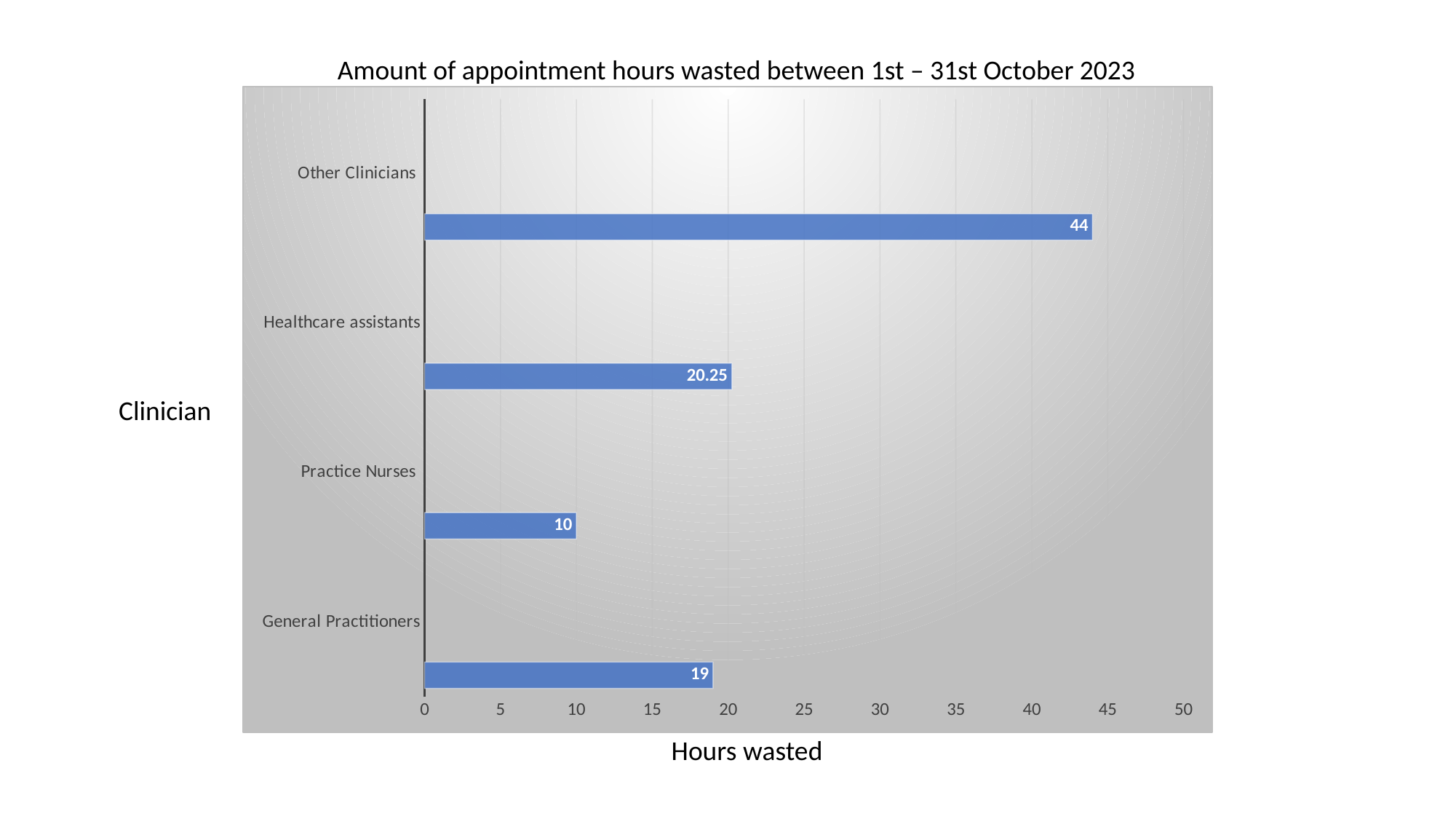
How many hours were wasted for Practice Nurses? 10 How many hours were wasted for Other Clinicians? 44 What type of chart is shown on the slide? bar chart What is the title of the chart? Amount of appointment hours wasted between 1st – 31st October 2023 Which clinician group has the lowest number of hours wasted? Practice Nurses What is the difference in hours wasted between Other Clinicians and General Practitioners? 25 How many hours were wasted for Healthcare assistants? 20.25 Which has more hours wasted, Healthcare assistants or General Practitioners? Healthcare assistants What is the difference in hours wasted between Healthcare assistants and Practice Nurses? 10.25 How many hours were wasted for General Practitioners? 19 How many clinician categories are shown in the chart? 4 Which clinician group has the highest number of hours wasted? Other Clinicians